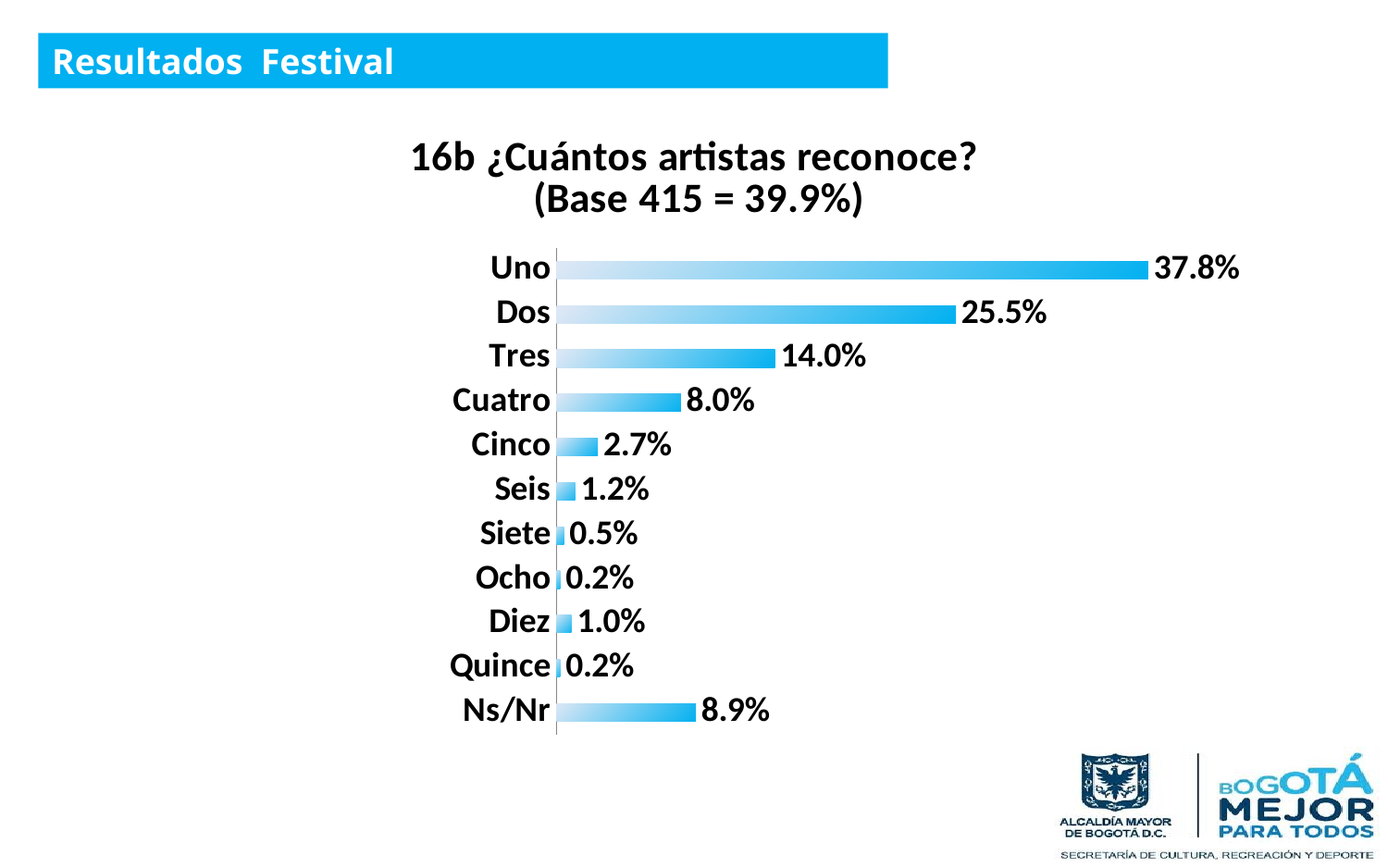
What is the title of the chart? 16b ¿Cuántos artistas reconoce? (Base 415 = 39.9%) How many categories are shown in the chart? 11 Which is larger, the value for Cinco or the value for Seis? Cinco What is the value for Diez? 1.0% What is the value for Ns/Nr? 8.9% Which category has the highest value? Uno Which is larger, the value for Ns/Nr or the value for Cuatro? Ns/Nr What is the difference between the values for Uno and Dos? 12.3% What is the difference between the values for Ns/Nr and Cuatro? 0.9% What kind of chart is shown on the slide? Bar chart What is the value for Tres? 14.0% What is the value for Uno? 37.8%